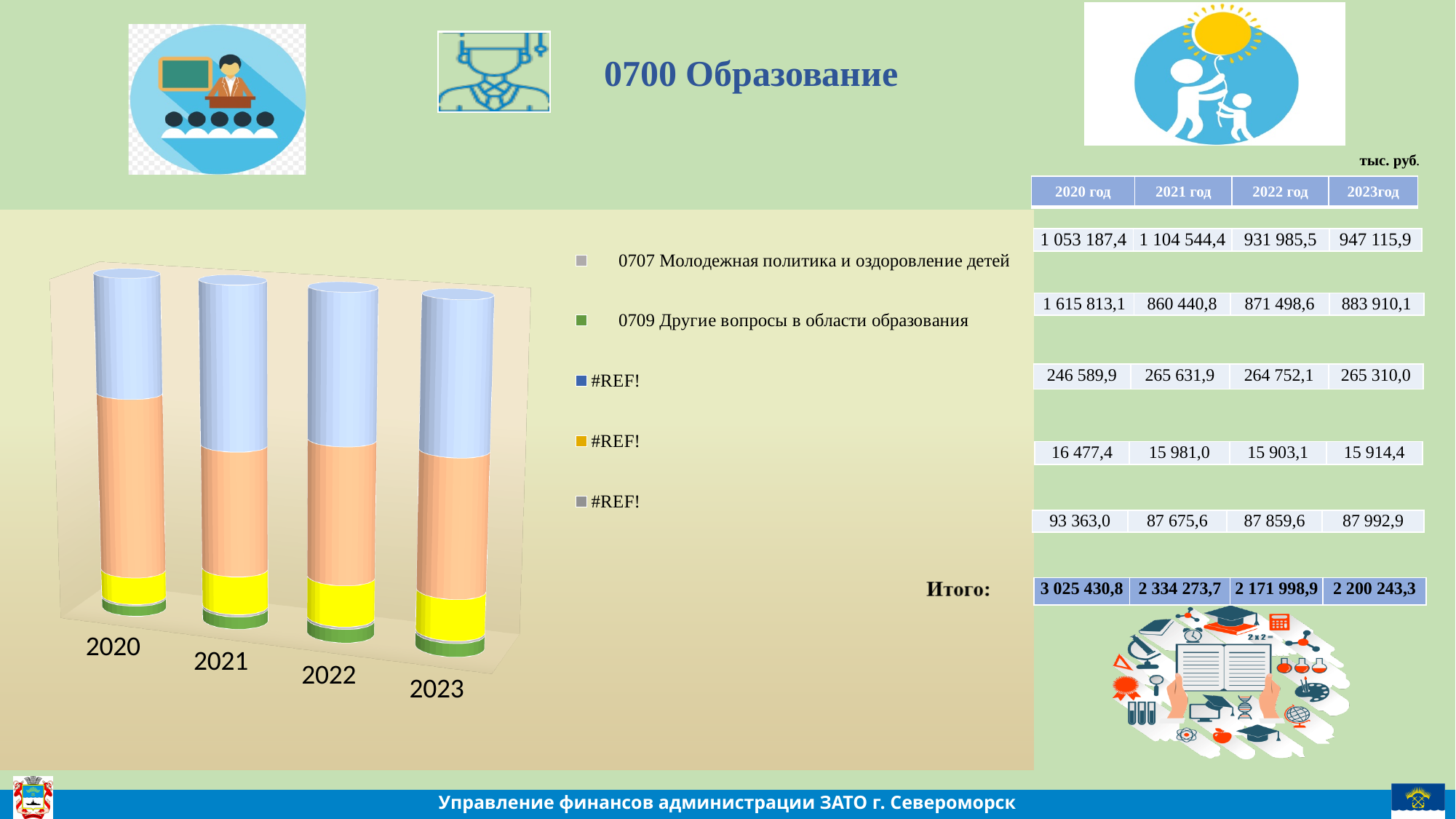
In the table, what is the difference between the Итого values for 2020 год and 2021 год? 691 157,1 What is the title shown at the top of the slide? 0700 Образование What kind of chart is shown on the slide? bar chart In the table, what is the Итого value for 2020 год? 3 025 430,8 What is the first legend entry of the chart? 0707 Молодежная политика и оздоровление детей How many years (categories) are shown along the x axis of the chart? 4 In the table, what is the Итого value for 2023год? 2 200 243,3 How many entries does the chart legend list? 5 In the table, which year has the lowest Итого value? 2022 год In the table, which year has the highest Итого value? 2020 год